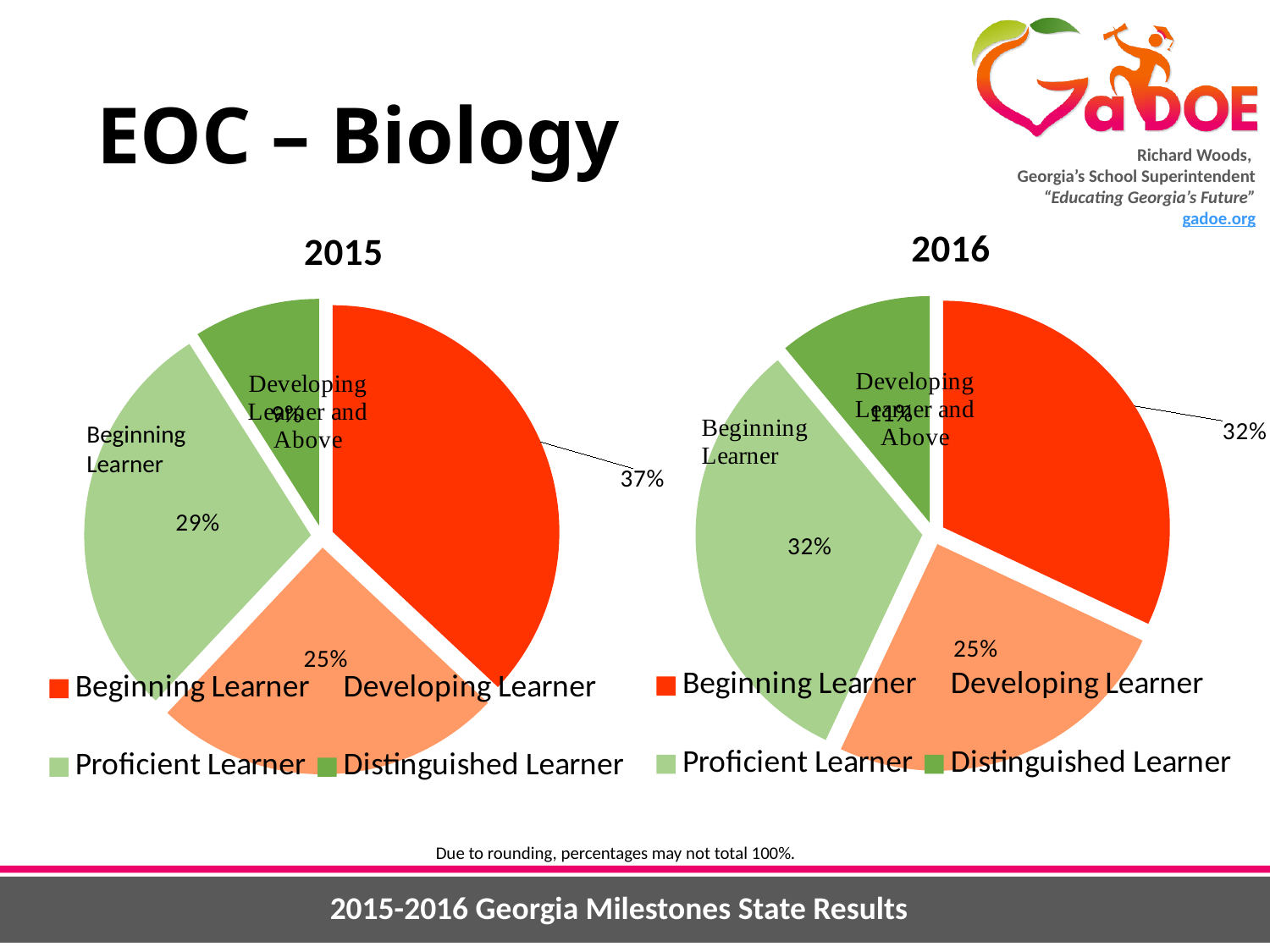
In the 2015 pie chart, what percentage is shown for Developing Learner? 25% In the 2016 pie chart, what percentage is shown for Developing Learner? 25% In the 2016 pie chart, what percentage is shown for Beginning Learner? 32% In the 2015 pie chart, what percentage is shown for Proficient Learner? 29% Comparing the two charts, is the Beginning Learner share higher in 2015 or in 2016? 2015 In the 2015 pie chart, which category has the smallest share? Distinguished Learner In the 2015 pie chart, what percentage is shown for Beginning Learner? 37% In the 2016 pie chart, what percentage is shown for Proficient Learner? 32% In the 2015 pie chart, what is the difference in percentage points between Beginning Learner and Proficient Learner? 8 percentage points In the 2016 pie chart, which category has the smallest share? Distinguished Learner In the 2015 pie chart, which category has the largest share? Beginning Learner What type of chart is used to show the 2015 and 2016 results? Pie chart